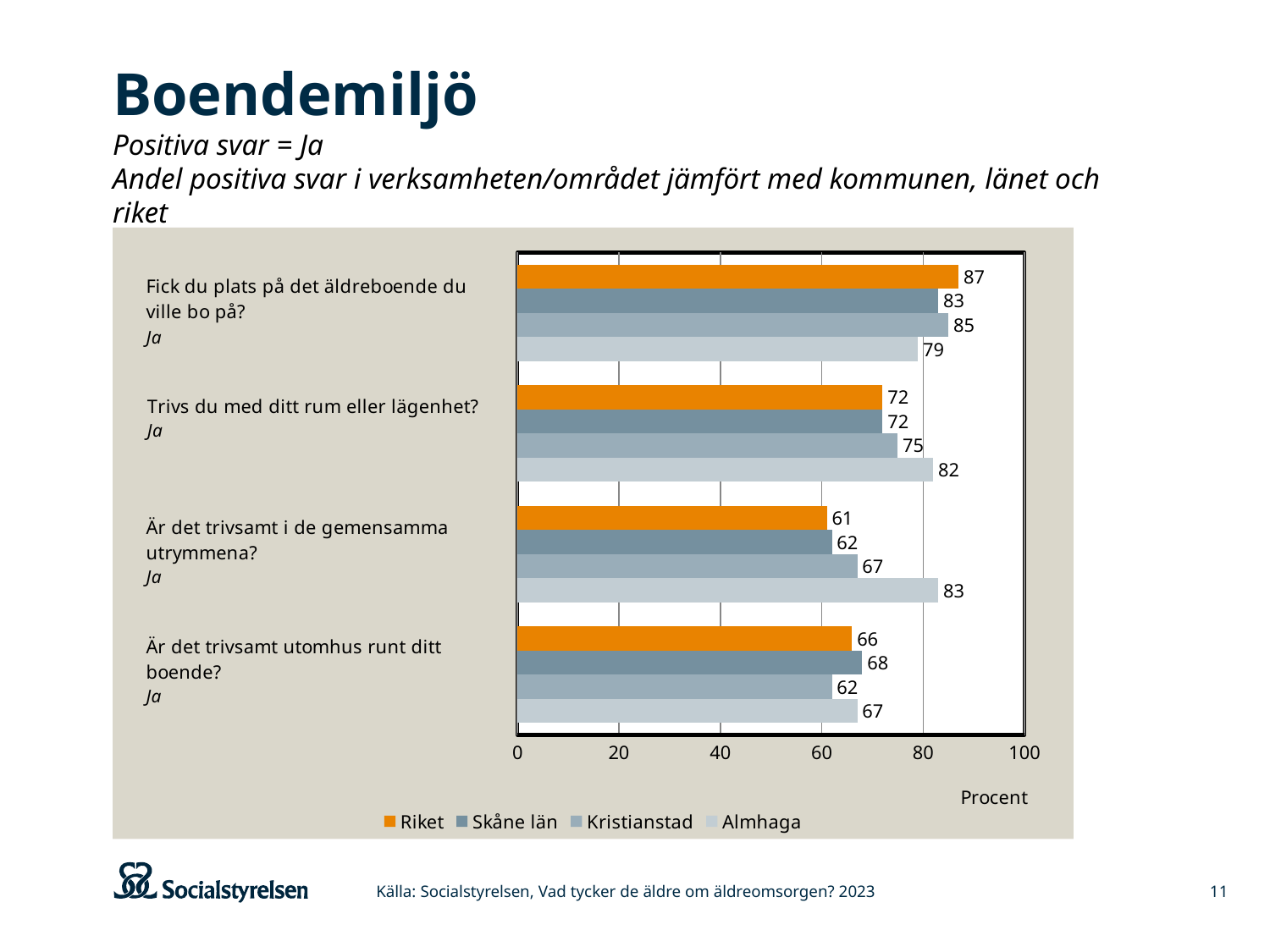
What kind of chart is shown on the slide? Bar chart What is the difference between Almhaga and Riket on "Är det trivsamt i de gemensamma utrymmena?"? 22 What is the value for Skåne län on "Är det trivsamt utomhus runt ditt boende?"? 68 Which series has the lowest value on "Fick du plats på det äldreboende du ville bo på?"? Almhaga What is the value for Riket on "Fick du plats på det äldreboende du ville bo på?"? 87 Which is larger on "Är det trivsamt utomhus runt ditt boende?": Skåne län or Kristianstad? Skåne län Which series has the highest value on "Är det trivsamt i de gemensamma utrymmena?"? Almhaga How many questions (categories) are shown on the chart? 4 How many series does the legend list? 4 What is the value for Almhaga on "Är det trivsamt i de gemensamma utrymmena?"? 83 What is the value for Kristianstad on "Trivs du med ditt rum eller lägenhet?"? 75 Is the value for Almhaga on "Trivs du med ditt rum eller lägenhet?" greater or less than 80? greater